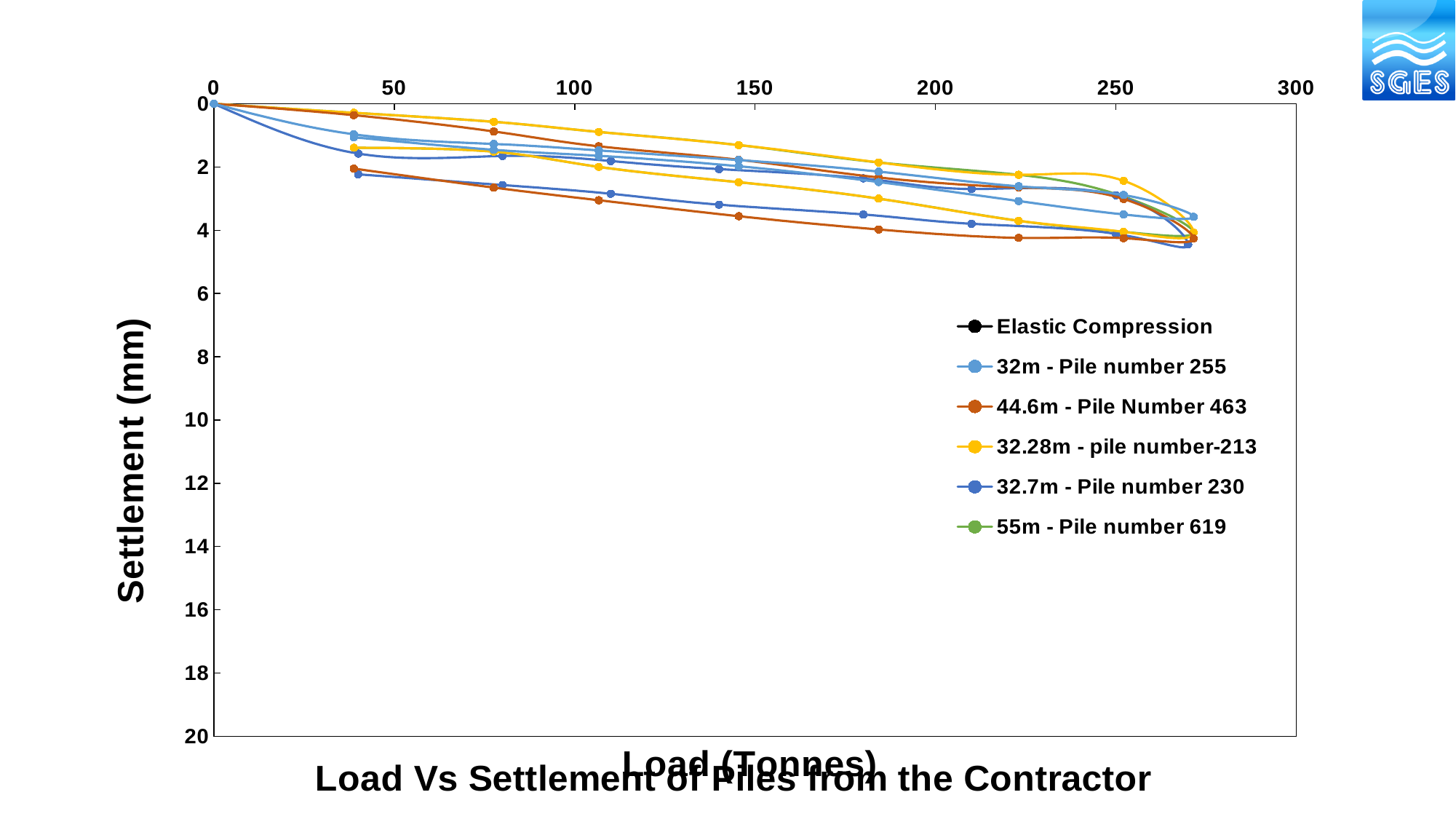
Is the settlement of the 44.6m - Pile Number 463 series at a load of 250 tonnes greater or less than 2 mm? greater Is the maximum load applied to the piles greater or less than 300 tonnes? less Which pile number is associated with the 55m series in the legend? Pile number 619 What kind of chart is shown on the slide? Line chart What is the title of the chart? Load Vs Settlement of Piles from the Contractor How many series does the legend list? 6 Does settlement increase or decrease as the load increases during loading? increase What is the label of the vertical axis? Settlement (mm) Is the maximum load applied to the piles greater or less than 250 tonnes? greater Which pile length is associated with Pile Number 463 in the legend? 44.6m What is the highest value shown on the Load (Tonnes) axis? 300